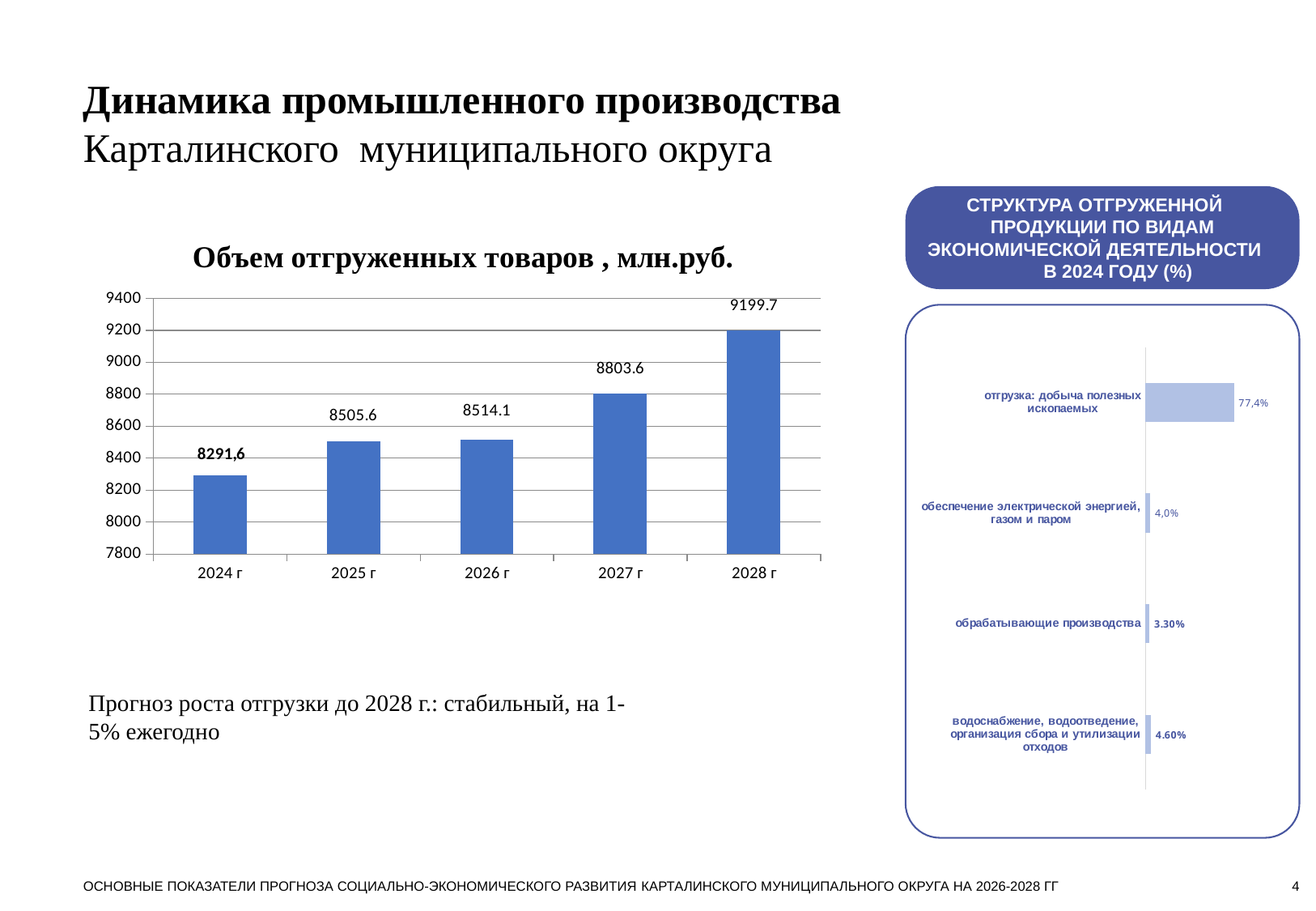
In the chart 'Объем отгруженных товаров , млн.руб.', which year has the lowest value? 2024 г In the chart 'Структура отгруженной продукции по видам экономической деятельности в 2024 году (%)', what is the value for 'отгрузка: добыча полезных ископаемых'? 77,4% In the chart 'Объем отгруженных товаров , млн.руб.', which year has the highest value? 2028 г In the chart 'Объем отгруженных товаров , млн.руб.', do the values rise or fall from 2024 г to 2028 г? rise What kind of chart is 'Объем отгруженных товаров , млн.руб.'? bar chart In the chart 'Структура отгруженной продукции по видам экономической деятельности в 2024 году (%)', what is the value for 'обрабатывающие производства'? 3.30% In the chart 'Структура отгруженной продукции по видам экономической деятельности в 2024 году (%)', which is larger: 'обеспечение электрической энергией, газом и паром' or 'водоснабжение, водоотведение, организация сбора и утилизации отходов'? водоснабжение, водоотведение, организация сбора и утилизации отходов How many years are shown in the chart 'Объем отгруженных товаров , млн.руб.'? 5 In the chart 'Объем отгруженных товаров , млн.руб.', what is the value for 2027 г? 8803.6 In the chart 'Объем отгруженных товаров , млн.руб.', what is the difference between the values for 2028 г and 2024 г? 908.1 In the chart 'Структура отгруженной продукции по видам экономической деятельности в 2024 году (%)', which category has the lowest value? обрабатывающие производства In the chart 'Объем отгруженных товаров , млн.руб.', what is the value for 2024 г? 8291,6